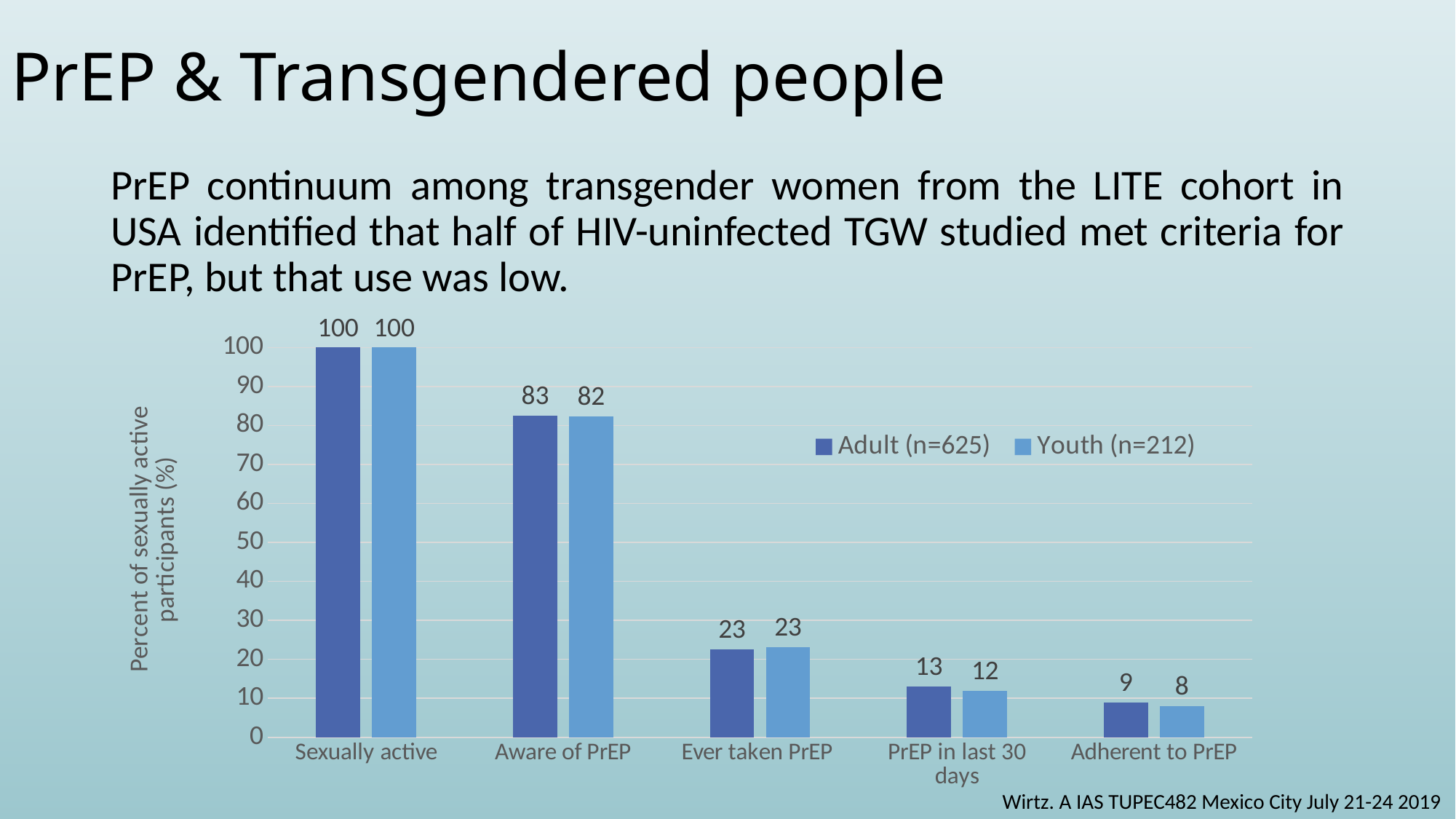
What is the value for Youth (n=212) in the PrEP in last 30 days category? 12 How many categories are shown on the x axis? 5 What is the value for Adult (n=625) in the Aware of PrEP category? 83 What is the difference between the Adult (n=625) value for Aware of PrEP and the Adult (n=625) value for Ever taken PrEP? 60 What is the difference between the Adult (n=625) and Youth (n=212) values for PrEP in last 30 days? 1 What is the label of the y axis? Percent of sexually active participants (%) What is the value for Youth (n=212) in the Adherent to PrEP category? 8 How many series does the legend list? 2 Which category has the lowest value for Adult (n=625)? Adherent to PrEP Which is larger: the Adult (n=625) value for Ever taken PrEP or the Adult (n=625) value for PrEP in last 30 days? Ever taken PrEP What kind of chart is shown on the slide? Bar chart Which category has the highest value for Youth (n=212)? Sexually active